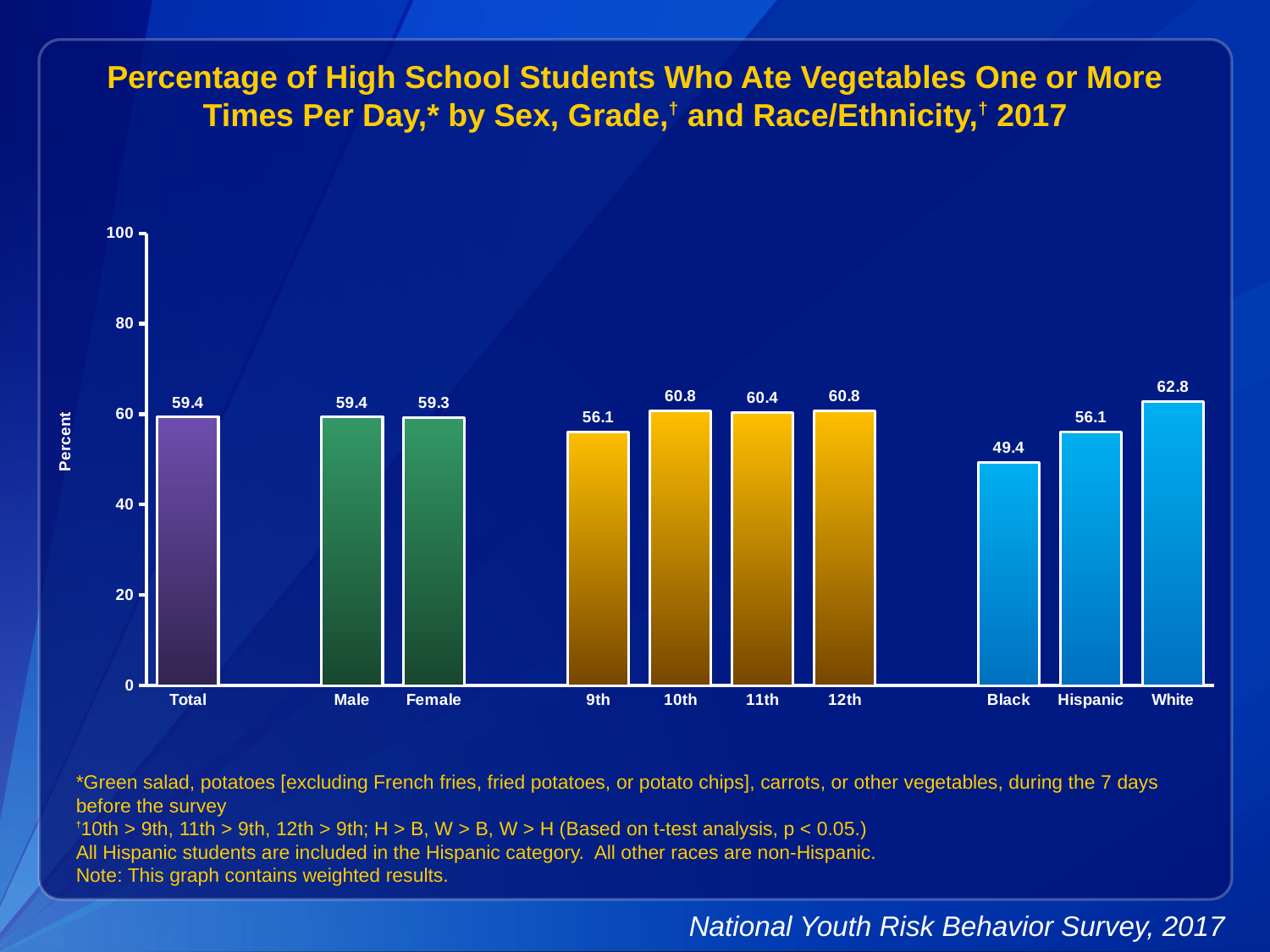
What is the difference between the values for White and Black students? 13.4 Which category has the highest value? White What is the label on the y axis? Percent What kind of chart is this? bar chart Which category has the lowest value? Black What is the value for 9th grade? 56.1 Which is larger, the value for Hispanic or the value for White? White How many bars are shown in the chart? 10 What is the value for Black students? 49.4 Is the value for Black students greater or less than 60? less What is the difference between the values for 10th grade and 9th grade? 4.7 What is the value for Total? 59.4